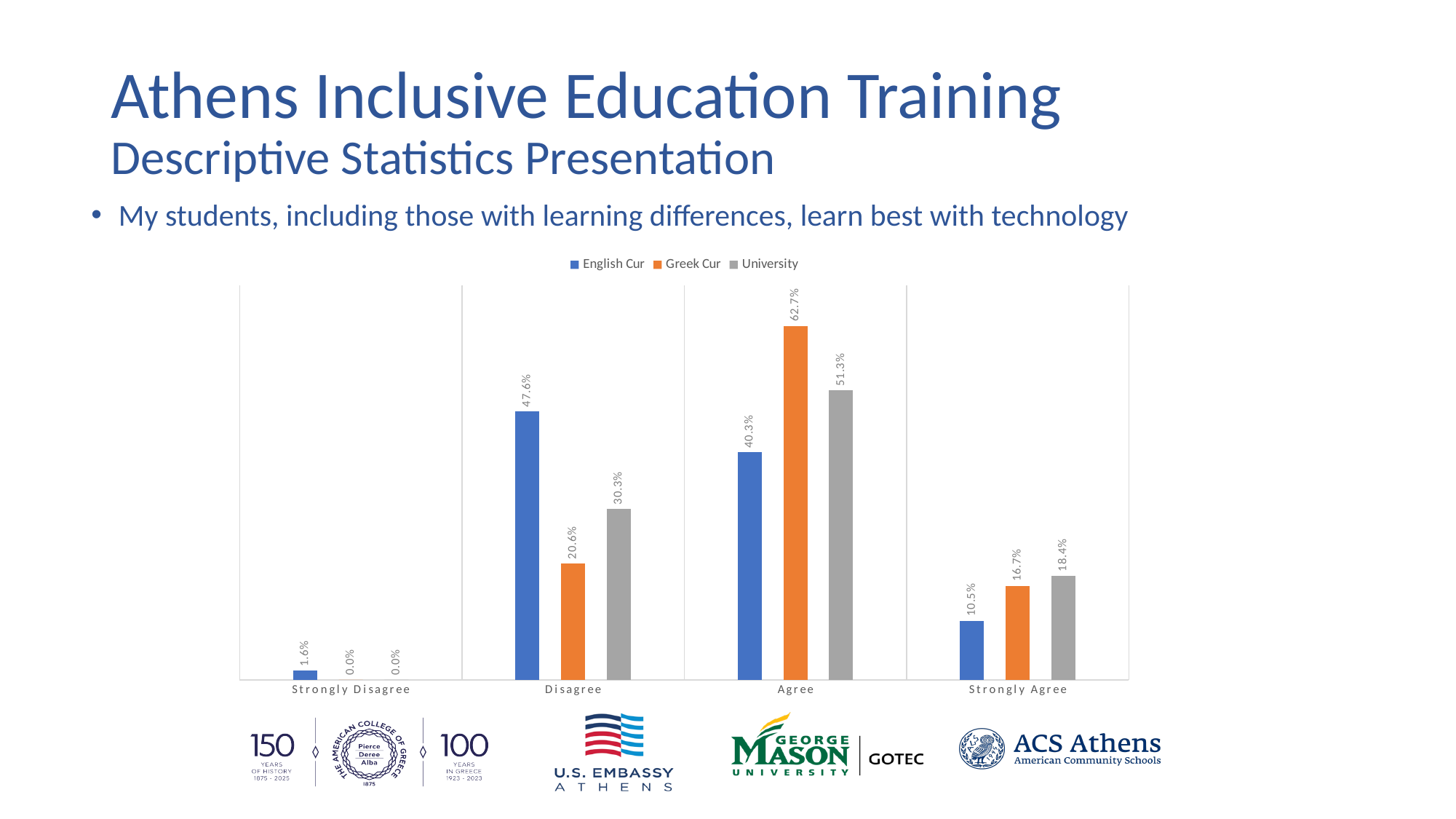
How many categories are shown on the x axis? 4 What is the value for University in the Strongly Agree category? 18.4% Which category has the lowest value for the University series? Strongly Disagree Which category has the highest value for the Greek Cur series? Agree What is the value for English Cur in the Disagree category? 47.6% What is the value for Greek Cur in the Agree category? 62.7% What is the difference between the Greek Cur and English Cur values in the Agree category? 22.4% What kind of chart is shown on the slide? Bar chart In the Disagree category, which series has the larger value, English Cur or University? English Cur What is the value for English Cur in the Strongly Disagree category? 1.6% What colour represents the Greek Cur series in the chart? Orange How many series does the legend list? 3